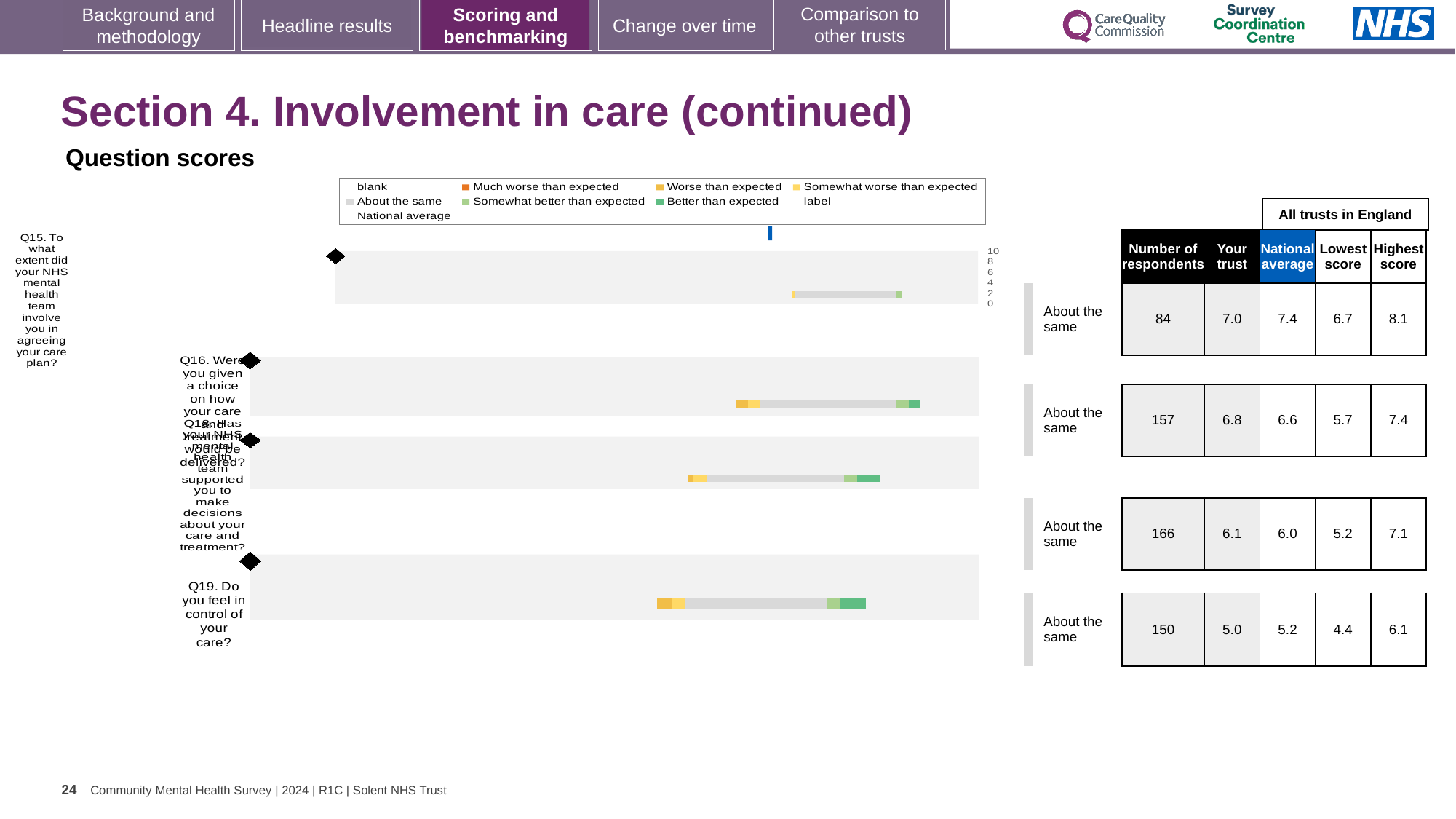
What kind of chart is shown under the heading 'Question scores'? bar chart What is the highest score among all trusts in England for Q19 (feeling in control of your care)? 6.1 What is the heading of the grouped columns 'National average', 'Lowest score' and 'Highest score' in the table beside the chart? All trusts in England For Q16, which is larger: the 'Your trust' score or the national average? Your trust How many survey questions are plotted in the 'Question scores' chart? 4 What benchmark category is shown for Q19 in the 'Question scores' chart? About the same What is the national average score for Q16 (choice on how care and treatment would be delivered)? 6.6 What is the difference between the highest score (8.1) and the lowest score (6.7) for Q15? 1.4 What is the 'Your trust' score for Q15 (involvement in agreeing your care plan)? 7.0 Which question has the lowest 'Your trust' score? Q19 Which question has the largest number of respondents? Q18 How many respondents answered Q18 (team supported you to make decisions)? 166